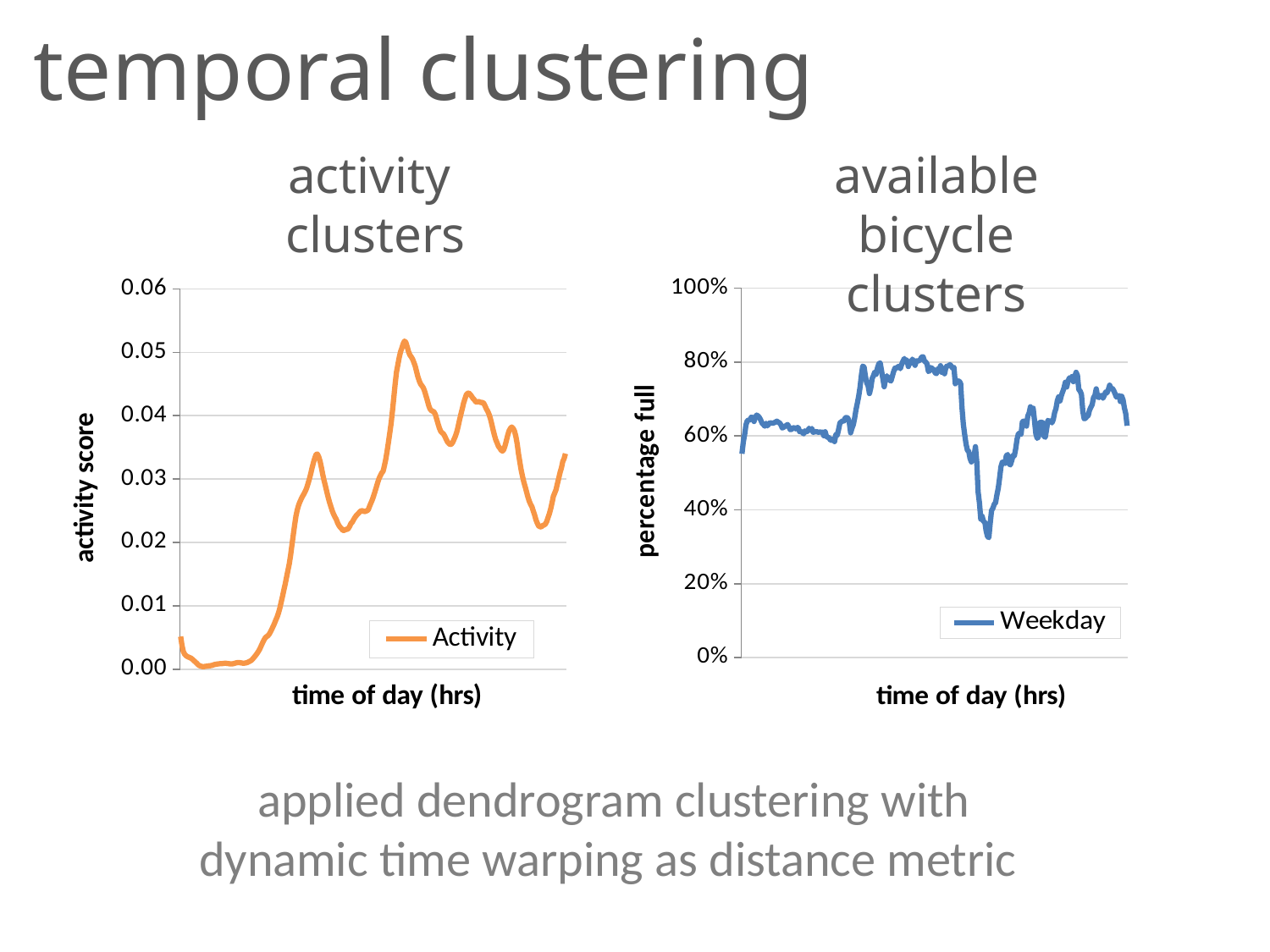
What is the y-axis title of the 'activity clusters' chart? activity score How many series does the legend of the 'activity clusters' chart list? 1 What kind of chart is the 'activity clusters' chart? line chart In the 'available bicycle clusters' chart, is the lowest value of the Weekday line greater or less than 40%? less What kind of chart is the 'available bicycle clusters' chart? line chart In the 'activity clusters' chart, is the highest value of the Activity line greater or less than 0.04? greater What is the name of the series shown in the legend of the 'available bicycle clusters' chart? Weekday In the 'available bicycle clusters' chart, is the highest value of the Weekday line greater or less than 100%? less In the 'activity clusters' chart, does the Activity line end higher or lower than it starts? higher How many series does the legend of the 'available bicycle clusters' chart list? 1